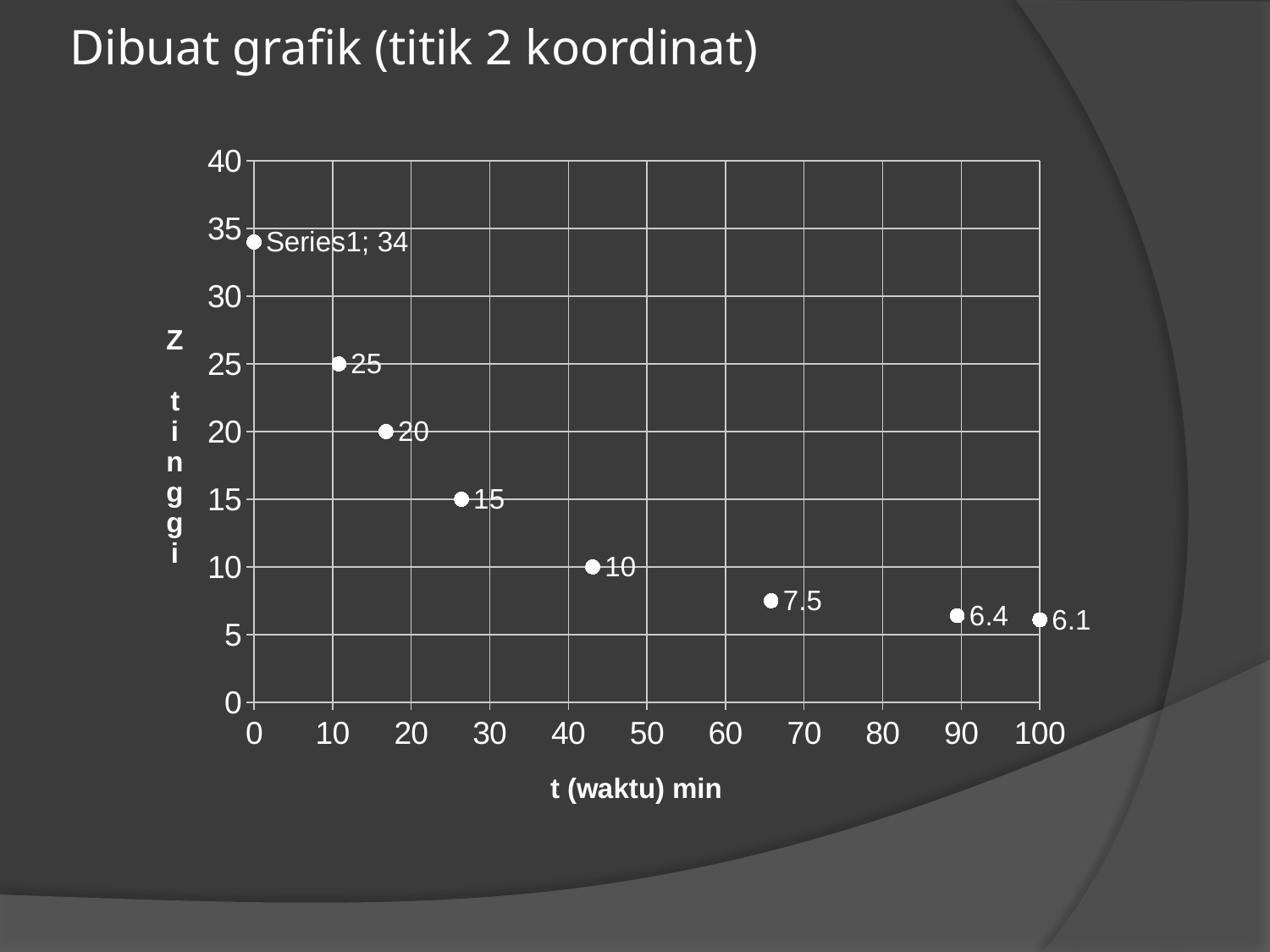
What is the title of the slide? Dibuat grafik (titik 2 koordinat) Which is larger, the point labelled 7.5 or the point labelled 6.4? 7.5 What is the lowest value labelled on the chart? 6.1 What is the title of the x axis? t (waktu) min Do the values rise or fall as t (waktu) increases along the x axis? fall What is the value of the data point at t = 0 min? 34 What is the highest value labelled on the chart? 34 Is the value of the point plotted between t = 60 and t = 70 greater or less than 10? less What is the difference between the highest labelled value (34) and the lowest labelled value (6.1)? 27.9 What is the value of the data point at t = 100 min? 6.1 How many data points are plotted on the chart? 8 What kind of chart is shown on the slide? scatter chart